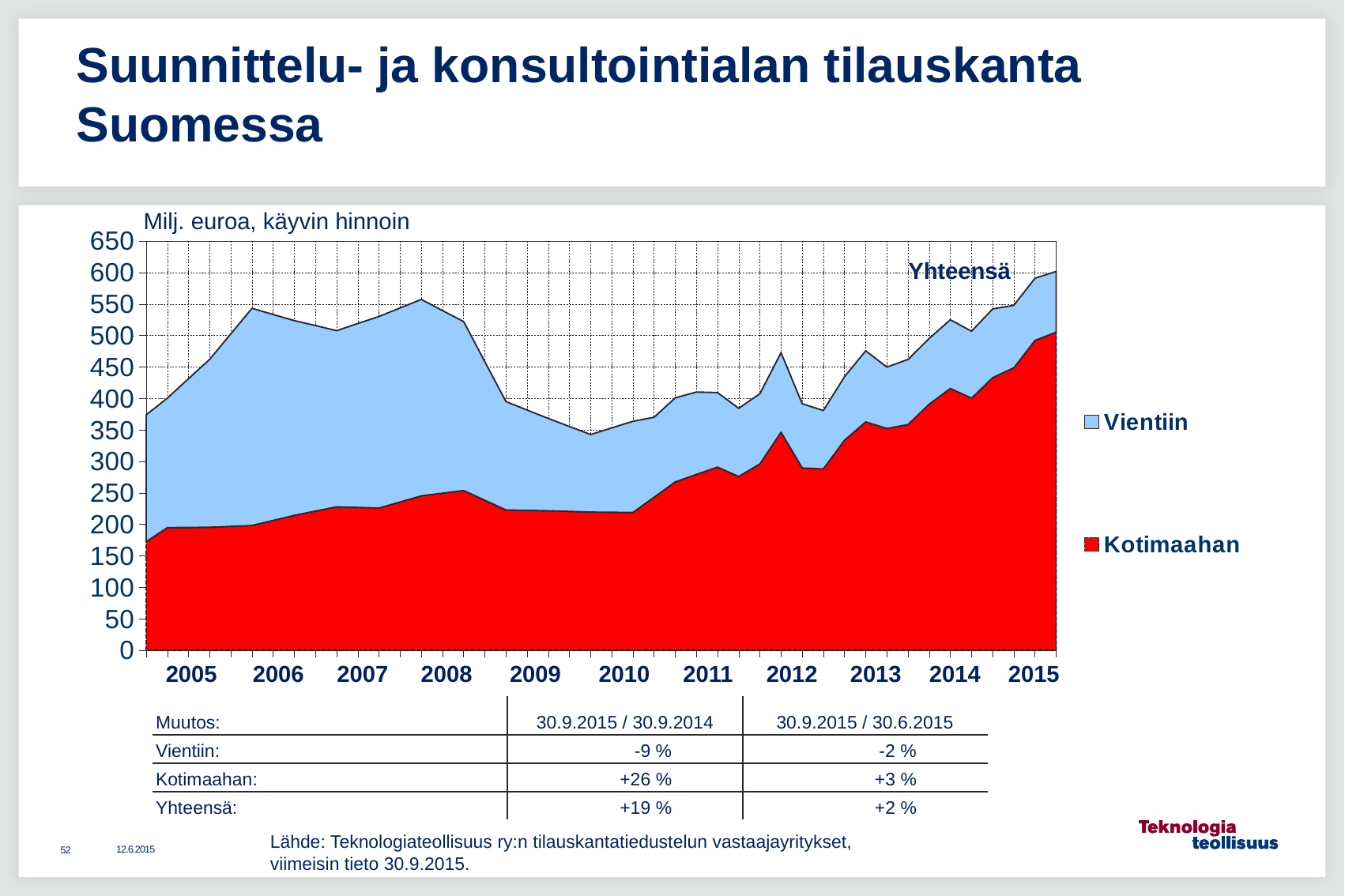
What unit is stated above the chart? Milj. euroa, käyvin hinnoin What are the two series named in the chart legend? Vientiin and Kotimaahan According to the table below the chart, what is the Kotimaahan change for 30.9.2015 / 30.9.2014? +26 % Is the Yhteensä (total) value at its 2008 peak greater or less than 500? greater How many years are labelled on the x axis of the chart? 11 Does the Kotimaahan series rise or fall between 2010 and 2015? rise Is the Yhteensä (total) value at the end of 2015 greater or less than 550? greater What kind of chart is shown on the slide? area chart Is the Kotimaahan value at the end of 2015 greater or less than 450? greater Does the Yhteensä (total) line rise or fall between 2008 and 2009? fall How many series does the chart legend list? 2